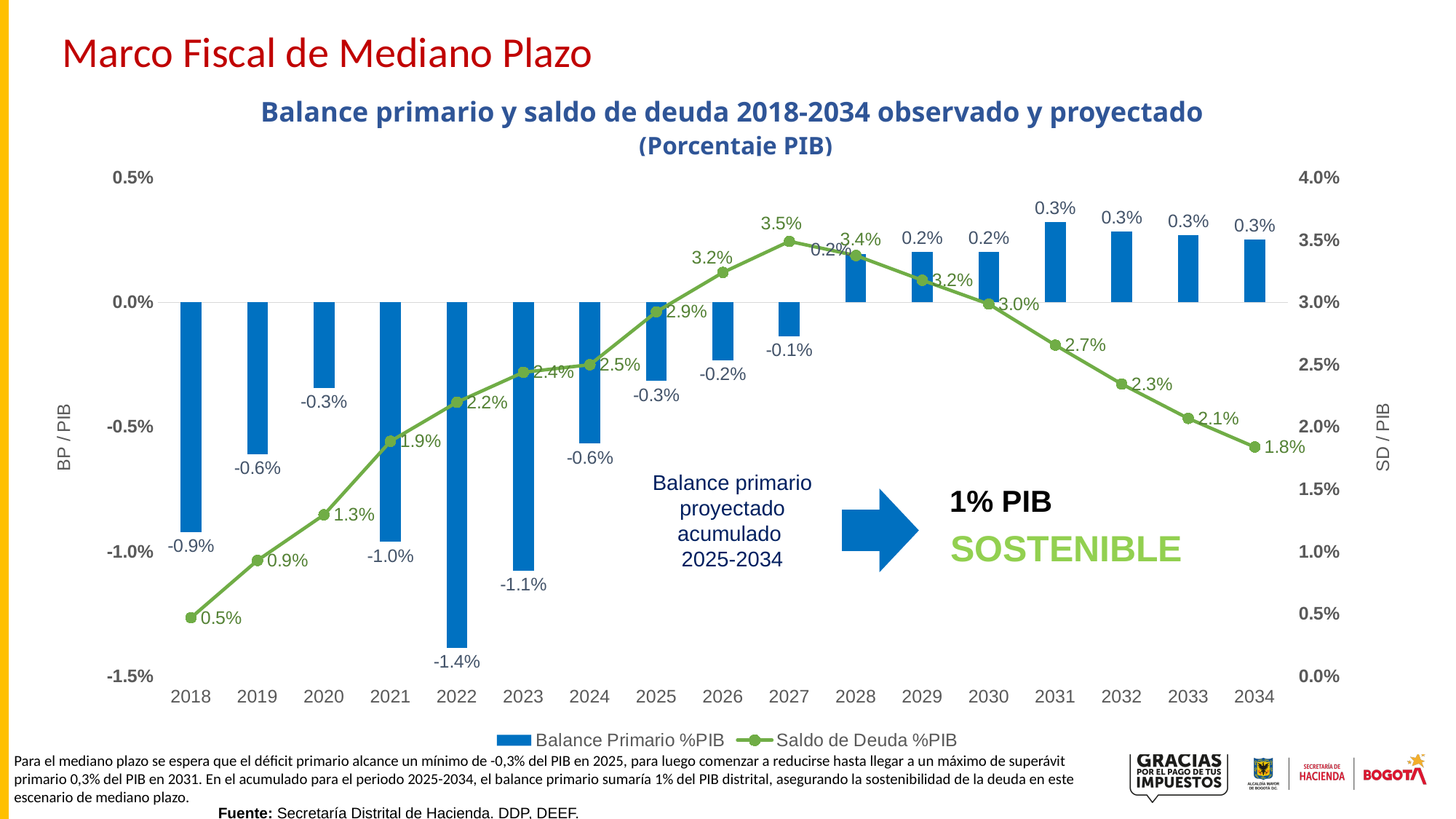
What kind of chart is shown on the slide? Combined bar and line chart What is the Saldo de Deuda %PIB value for 2027? 3.5% How many series does the chart legend list? 2 In which year does the Saldo de Deuda %PIB line reach its highest value? 2027 In which year is the Balance Primario %PIB bar at its lowest value? 2022 How many years are shown on the x axis of the chart? 17 What is the Balance Primario %PIB value for 2022? -1.4% What is the Balance Primario %PIB value for 2031? 0.3% Does the Saldo de Deuda %PIB line rise or fall from 2018 to 2027? Rise What is the difference between the Saldo de Deuda %PIB values for 2027 and 2034? 1.7% What is the Saldo de Deuda %PIB value for 2034? 1.8% Which year has a higher Saldo de Deuda %PIB value, 2021 or 2030? 2030